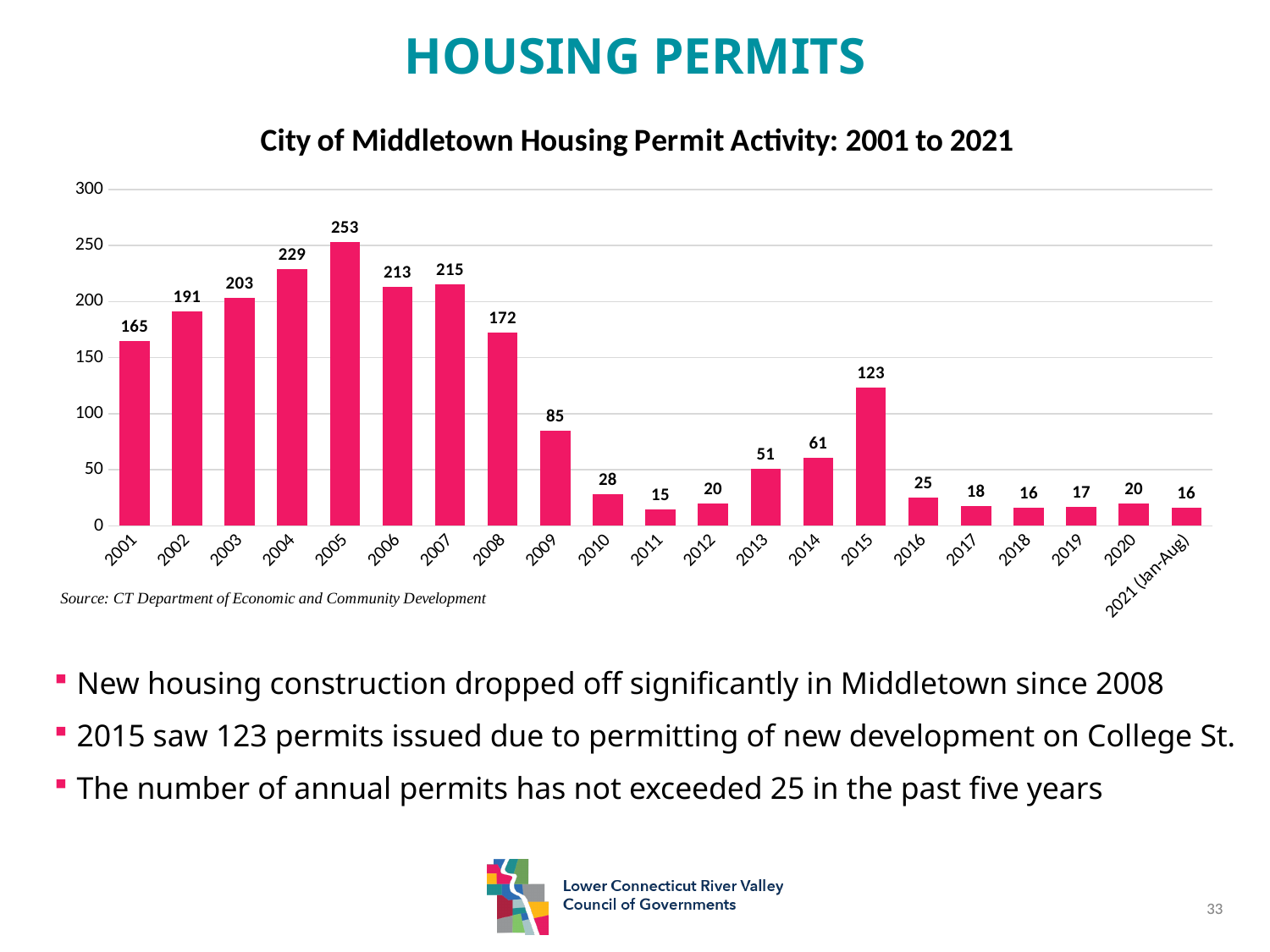
How many bars are plotted in the chart? 21 What is the title of the chart? City of Middletown Housing Permit Activity: 2001 to 2021 How many housing permits were issued in Middletown in 2005? 253 Which year has the lowest number of housing permits? 2011 Which year had more permits, 2013 or 2014? 2014 Do the values generally rise or fall from 2005 to 2011? Fall Which year has the highest number of housing permits? 2005 What is the value shown for 2015? 123 Is the value for 2007 greater or less than 200? greater What kind of chart is shown on the slide? Bar chart What is the difference between the permits in 2008 and 2009? 87 What is the value shown for 2021 (Jan-Aug)? 16